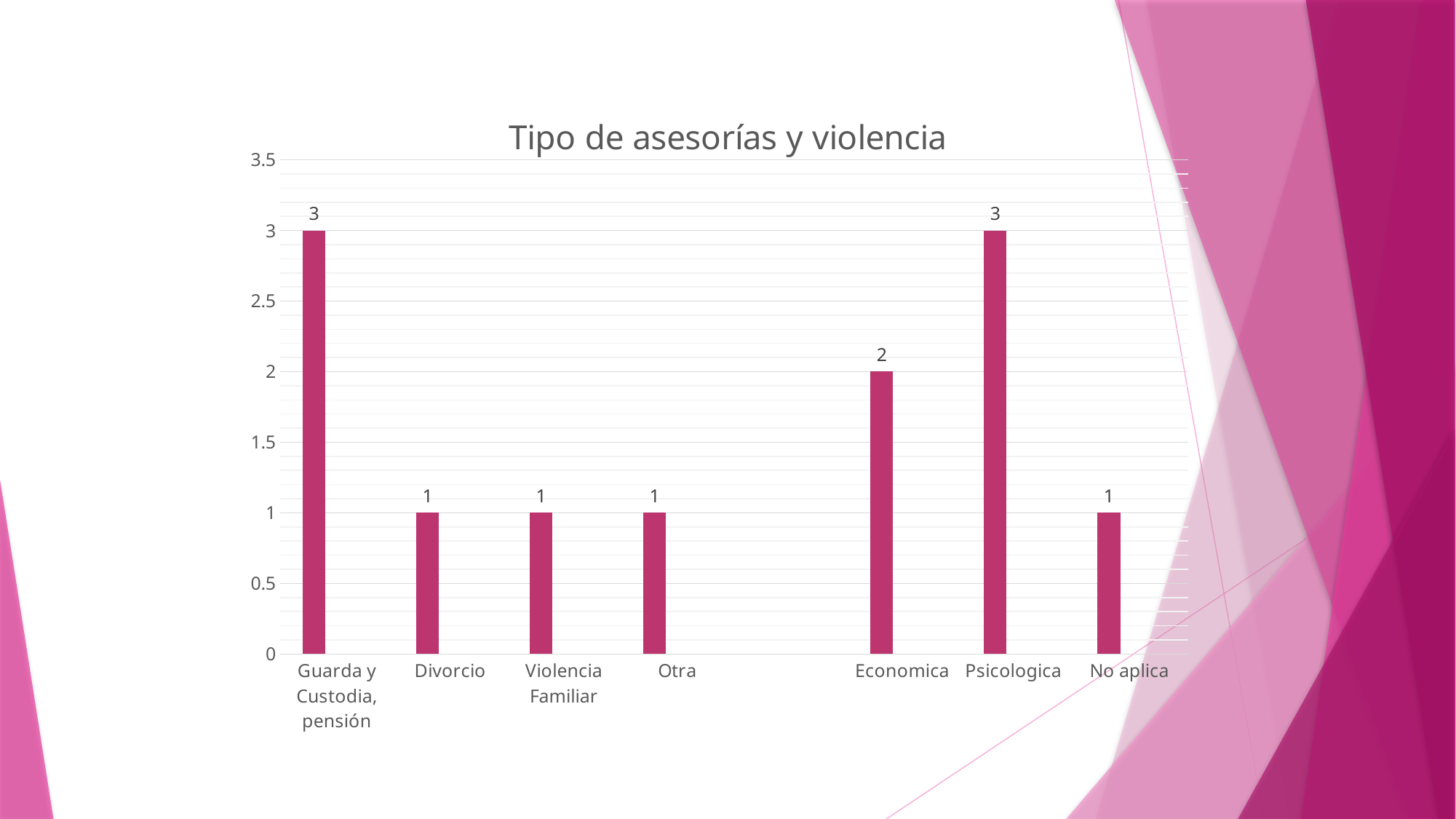
What is the difference between the values for Psicologica and Economica? 1 What kind of chart is shown on the slide? Bar chart What is the value for Economica? 2 What is the value for Guarda y Custodia, pensión? 3 What is the title of the chart? Tipo de asesorías y violencia What is the value for No aplica? 1 Which is larger, the value for Guarda y Custodia, pensión or the value for Economica? Guarda y Custodia, pensión What is the value for Psicologica? 3 What is the value for Divorcio? 1 What is the difference between the values for Guarda y Custodia, pensión and Otra? 2 How many bars are plotted in the chart? 7 Which is larger, the value for Economica or the value for Violencia Familiar? Economica